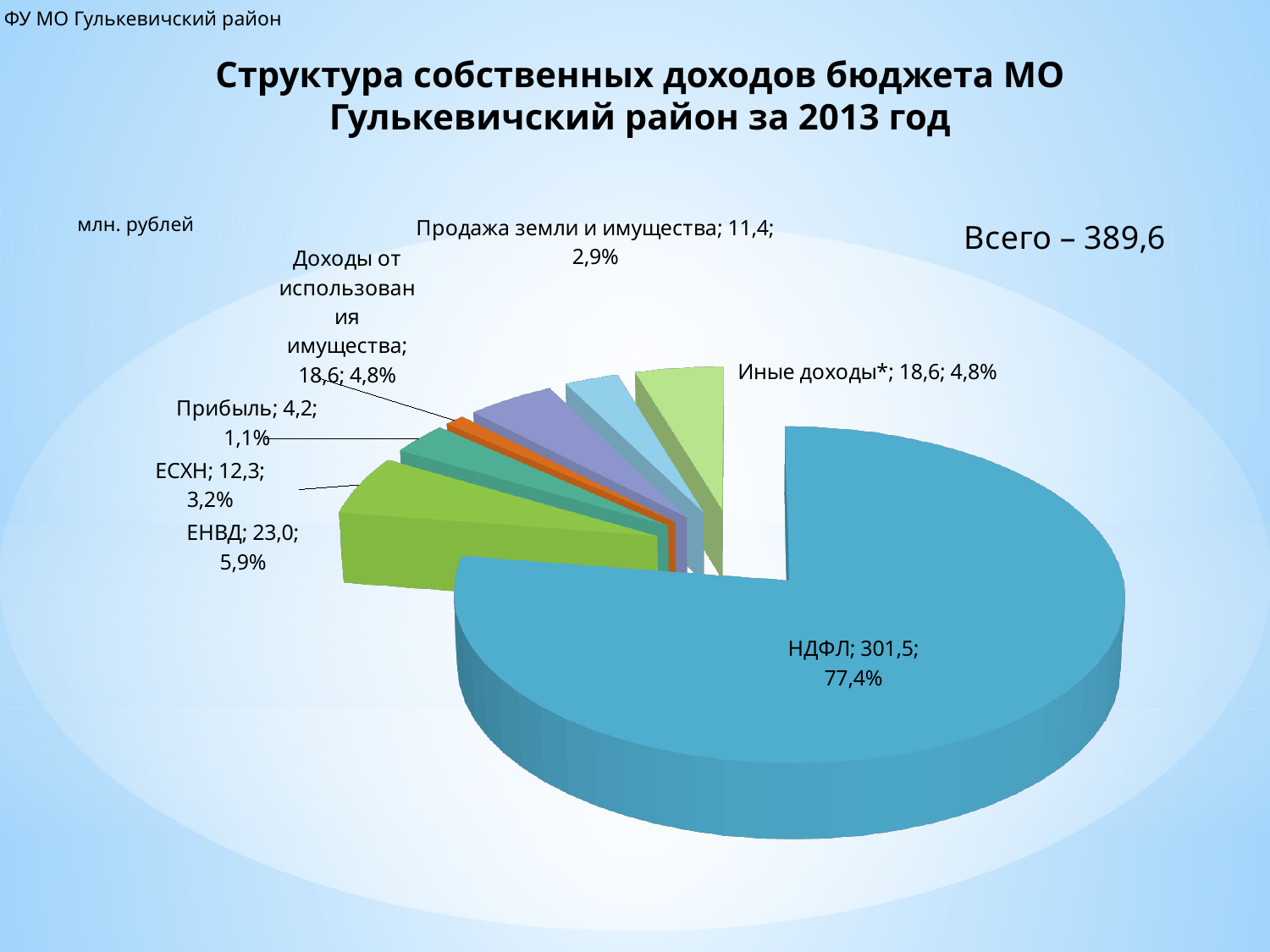
How many slices does the pie chart have? 7 What share of the pie does НДФЛ account for? 77,4% Which is larger, the value for Продажа земли и имущества or the value for Иные доходы*? Иные доходы* Which category has the smallest slice of the pie? Прибыль What is the value for ЕНВД? 23,0 Which category has the largest slice of the pie? НДФЛ What is the value for НДФЛ in the pie chart? 301,5 What total is stated on the slide for all categories? 389,6 What is the difference between the values for ЕНВД and ЕСХН? 10,7 What unit is stated for the values in the chart? млн. рублей What share of the pie does ЕСХН account for? 3,2% What kind of chart is shown on the slide? pie chart